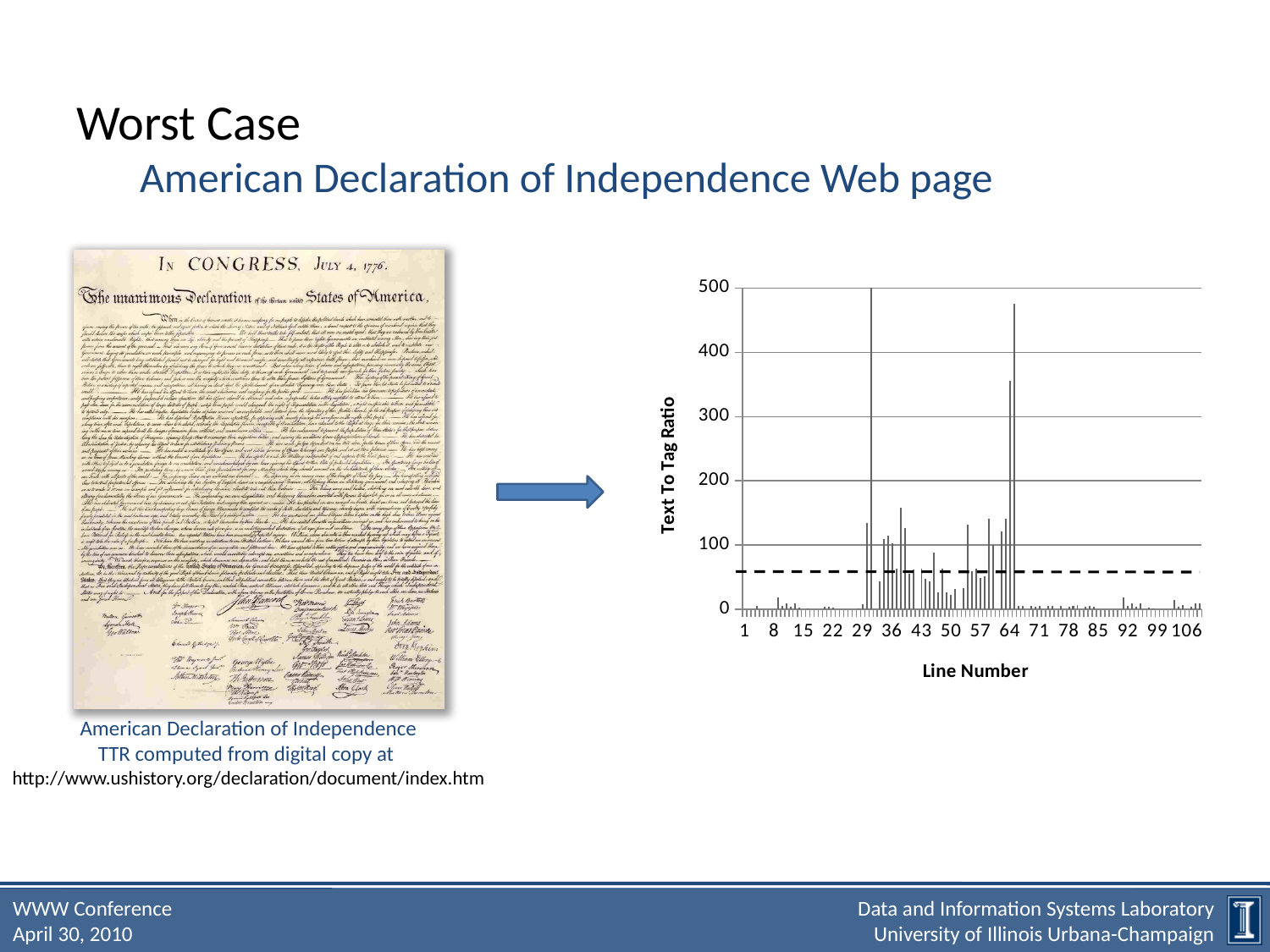
What kind of chart is shown on the slide? bar chart What is the last line number labelled on the x axis of the chart? 106 Is the value for line number 8 greater or less than 100? less Are the highest Text To Tag Ratio values found at the beginning, the middle, or the end of the line number range? middle What is the interval between consecutive labelled ticks on the y axis of the chart? 100 Is the value for line number 106 greater or less than 100? less What is the highest value shown on the y axis of the chart? 500 What is the label of the x axis of the chart? Line Number Is the dashed horizontal line in the chart above or below the 100 mark on the y axis? below What is the label of the y axis of the chart? Text To Tag Ratio